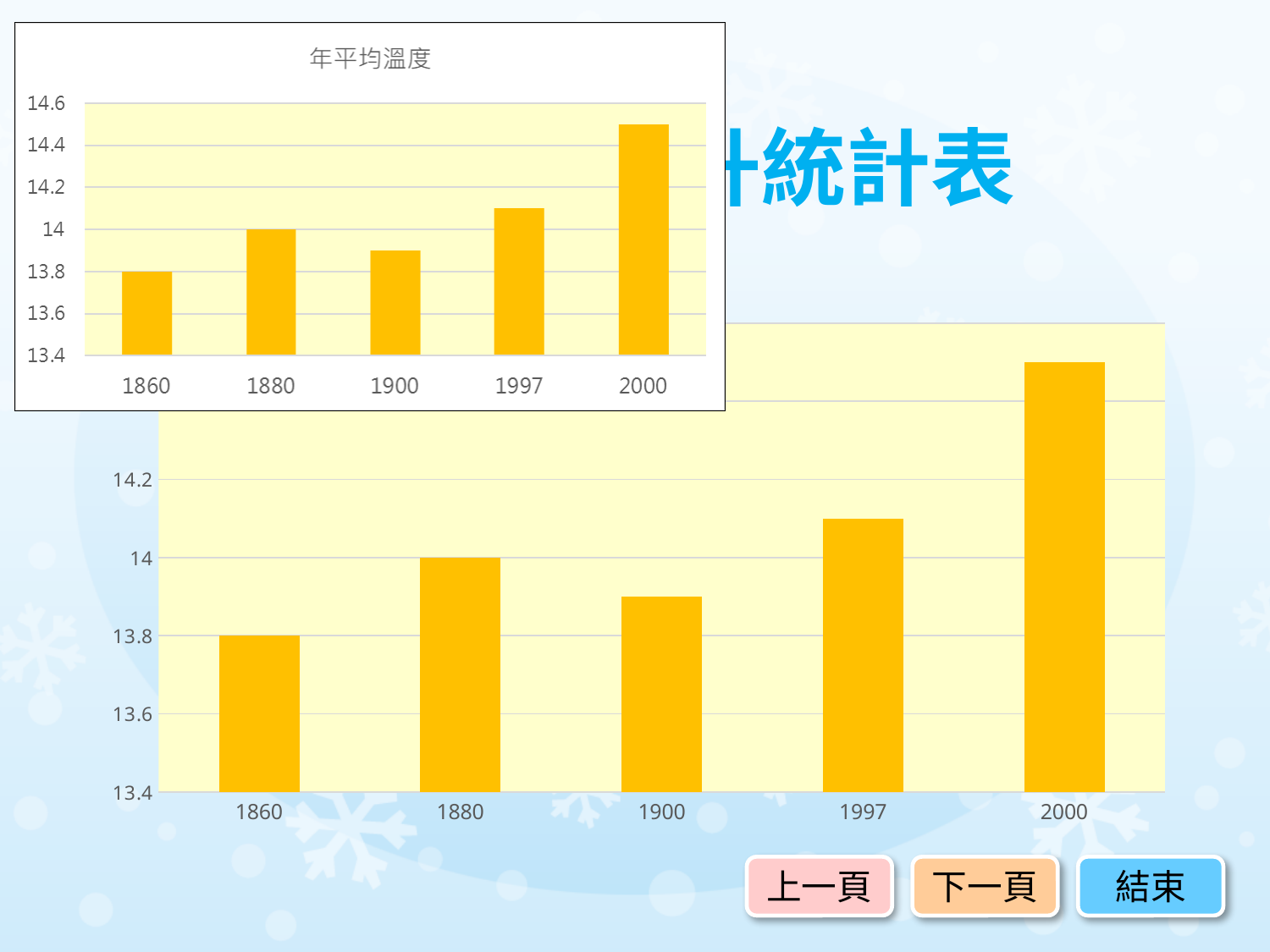
What is the title of the small chart at the top left of the slide? 年平均溫度 In the small chart at the top left titled 年平均溫度, which year has the highest value? 2000 In the small chart at the top left titled 年平均溫度, what is the value for 1880? 14 In the large chart at the bottom of the slide, which year has the lowest value? 1860 In the small chart at the top left titled 年平均溫度, what is the difference between the values for 1880 and 1860? 0.2 How many years are shown on the x axis of the small chart at the top left titled 年平均溫度? 5 In the large chart at the bottom of the slide, which is larger, the value for 1880 or the value for 1900? 1880 In the small chart at the top left titled 年平均溫度, what is the value for 1860? 13.8 In the large chart at the bottom of the slide, is the value for 1997 greater or less than 14.2? less What kind of chart is the large chart at the bottom of the slide? bar chart In the large chart at the bottom of the slide, what is the value for 1860? 13.8 In the small chart at the top left titled 年平均溫度, is the value for 2000 greater or less than 14.4? greater